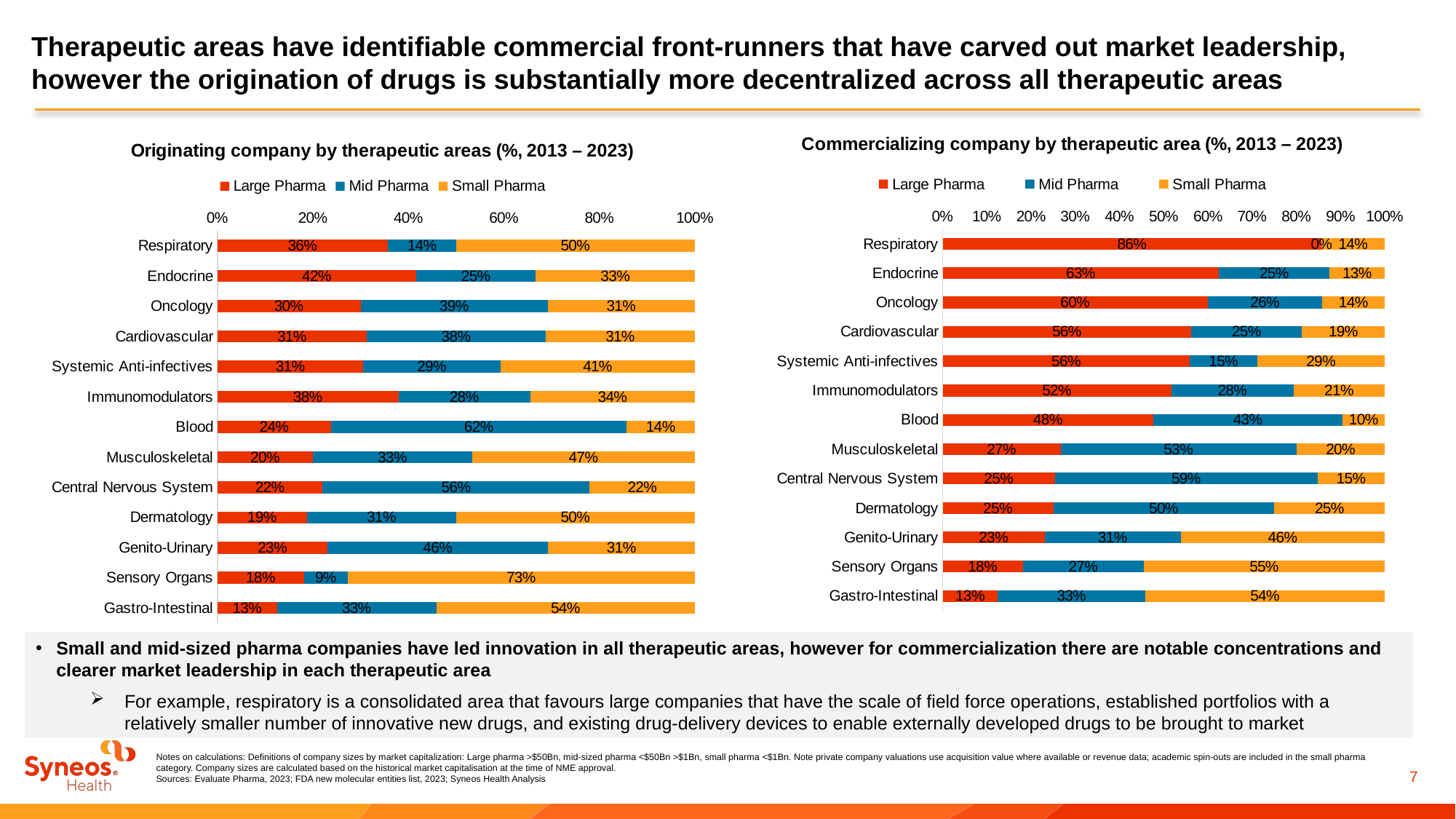
In the 'Commercializing company by therapeutic area' chart, which therapeutic area has the lowest Large Pharma value? Gastro-Intestinal How many series does the legend of the 'Originating company by therapeutic areas' chart list? 3 How many therapeutic areas are shown in the 'Commercializing company by therapeutic area' chart? 13 In the 'Commercializing company by therapeutic area' chart, what is the Large Pharma value for Respiratory? 86% In the 'Originating company by therapeutic areas' chart, which is larger for Oncology: the Mid Pharma value or the Small Pharma value? Mid Pharma In the 'Commercializing company by therapeutic area' chart, what is the difference between the Large Pharma values for Endocrine and Oncology? 3% In the 'Commercializing company by therapeutic area' chart, what is the Mid Pharma value for Central Nervous System? 59% In the 'Originating company by therapeutic areas' chart, which therapeutic area has the highest Mid Pharma value? Blood In the 'Originating company by therapeutic areas' chart, what is the combined Large Pharma and Mid Pharma value for Blood? 86% Which colour represents Small Pharma in the 'Originating company by therapeutic areas' chart? Orange In the 'Originating company by therapeutic areas' chart, what is the Small Pharma value for Sensory Organs? 73% What type of chart is the 'Commercializing company by therapeutic area' chart? Stacked bar chart